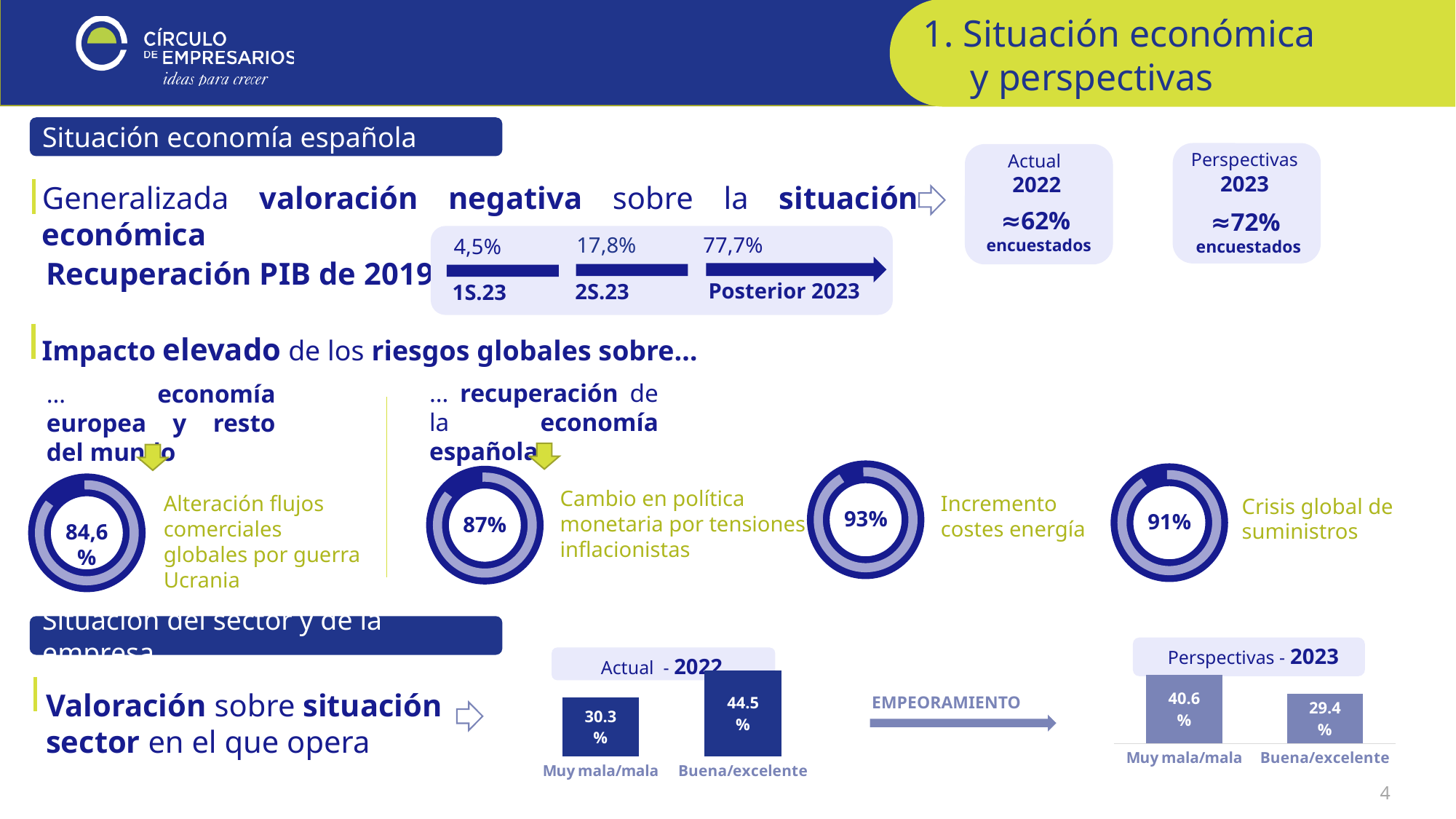
How many categories does the 'Perspectivas - 2023' bar chart show? 2 In the 'Perspectivas - 2023' bar chart, what is the value for Muy mala/mala? 40.6% What percentage is shown in the donut chart next to 'Incremento costes energía'? 93% In the 'Actual - 2022' bar chart, what is the value for Muy mala/mala? 30.3% In the 'Perspectivas - 2023' bar chart, what is the difference between Muy mala/mala and Buena/excelente? 11.2% In the 'Actual - 2022' bar chart, which category has the higher value? Buena/excelente In the 'Perspectivas - 2023' bar chart, what is the value for Buena/excelente? 29.4% In the 'Perspectivas - 2023' bar chart, which category has the lower value? Buena/excelente In the 'Actual - 2022' bar chart, what is the difference between Buena/excelente and Muy mala/mala? 14.2% What kind of chart is the 'Actual - 2022' chart at the bottom of the slide? bar chart In the 'Actual - 2022' bar chart, what is the value for Buena/excelente? 44.5% What percentage is shown in the donut chart next to 'Crisis global de suministros'? 91%